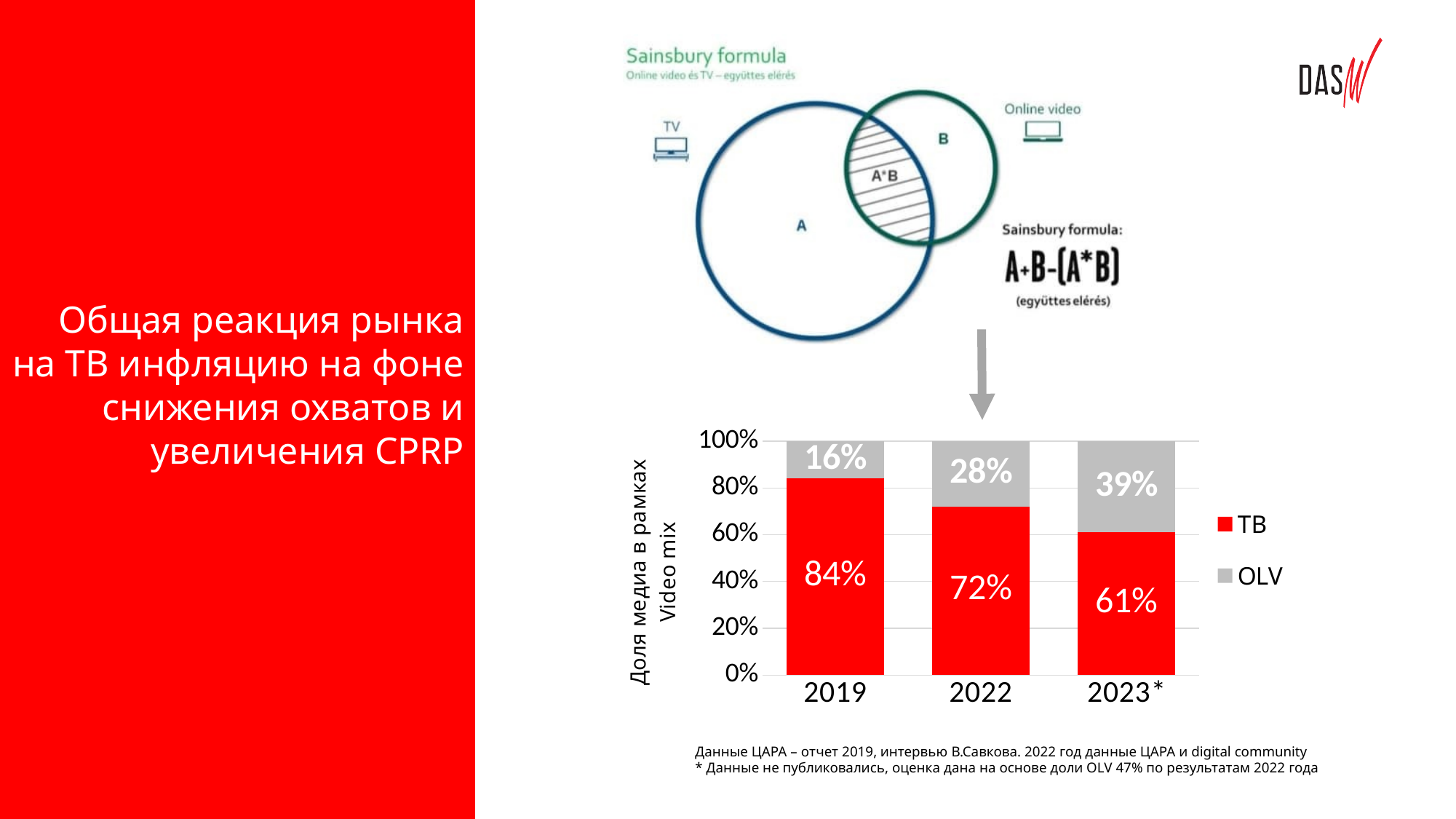
Which is larger in 2022, the TV share or the OLV share? TV What is the TV share of the video mix in 2023*? 61% In which year is the OLV share highest? 2023* In which year is the TV share lowest? 2023* By how many percentage points does the TV share fall from 2019 to 2023*? 23 What is the TV share of the video mix in 2019? 84% Does the TV share rise or fall from 2019 to 2023*? Fall What is the OLV share of the video mix in 2019? 16% How many series does the legend of the bar chart list? 2 What kind of chart shows the video mix shares? Stacked bar chart What is the OLV share of the video mix in 2022? 28% How many years are shown on the x axis of the bar chart? 3